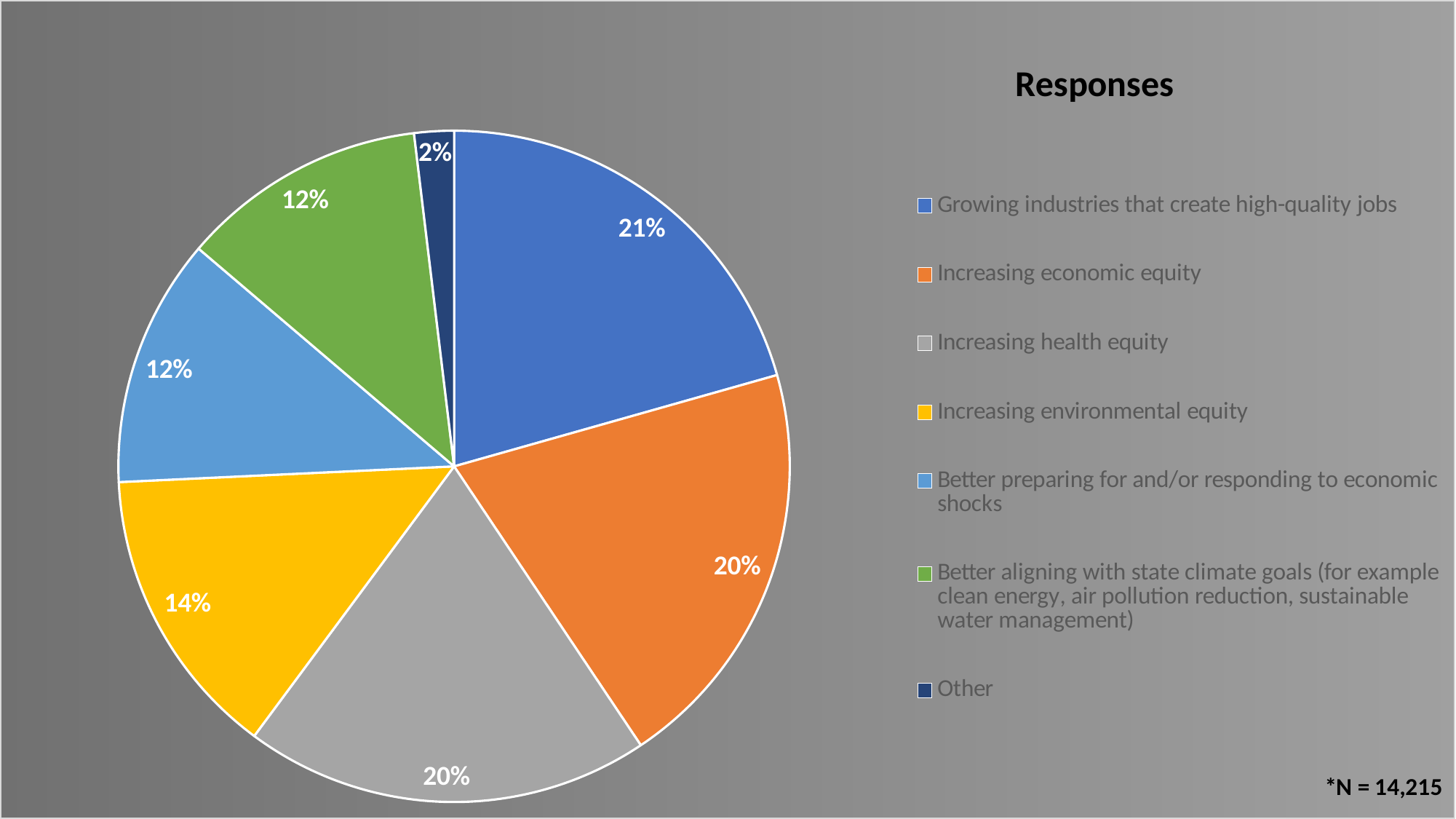
Which is larger: the share for 'Increasing health equity' or the share for 'Better aligning with state climate goals'? Increasing health equity What share of responses is 'Increasing economic equity'? 20% What share of responses is 'Other'? 2% What share of responses is 'Better preparing for and/or responding to economic shocks'? 12% How many slices does the pie chart have? 7 Which category has the largest share of responses? Growing industries that create high-quality jobs What type of chart is shown on the slide? pie chart Which category has the smallest share of responses? Other What is the title of the chart? Responses What is the difference in percentage points between 'Increasing environmental equity' and 'Other'? 12